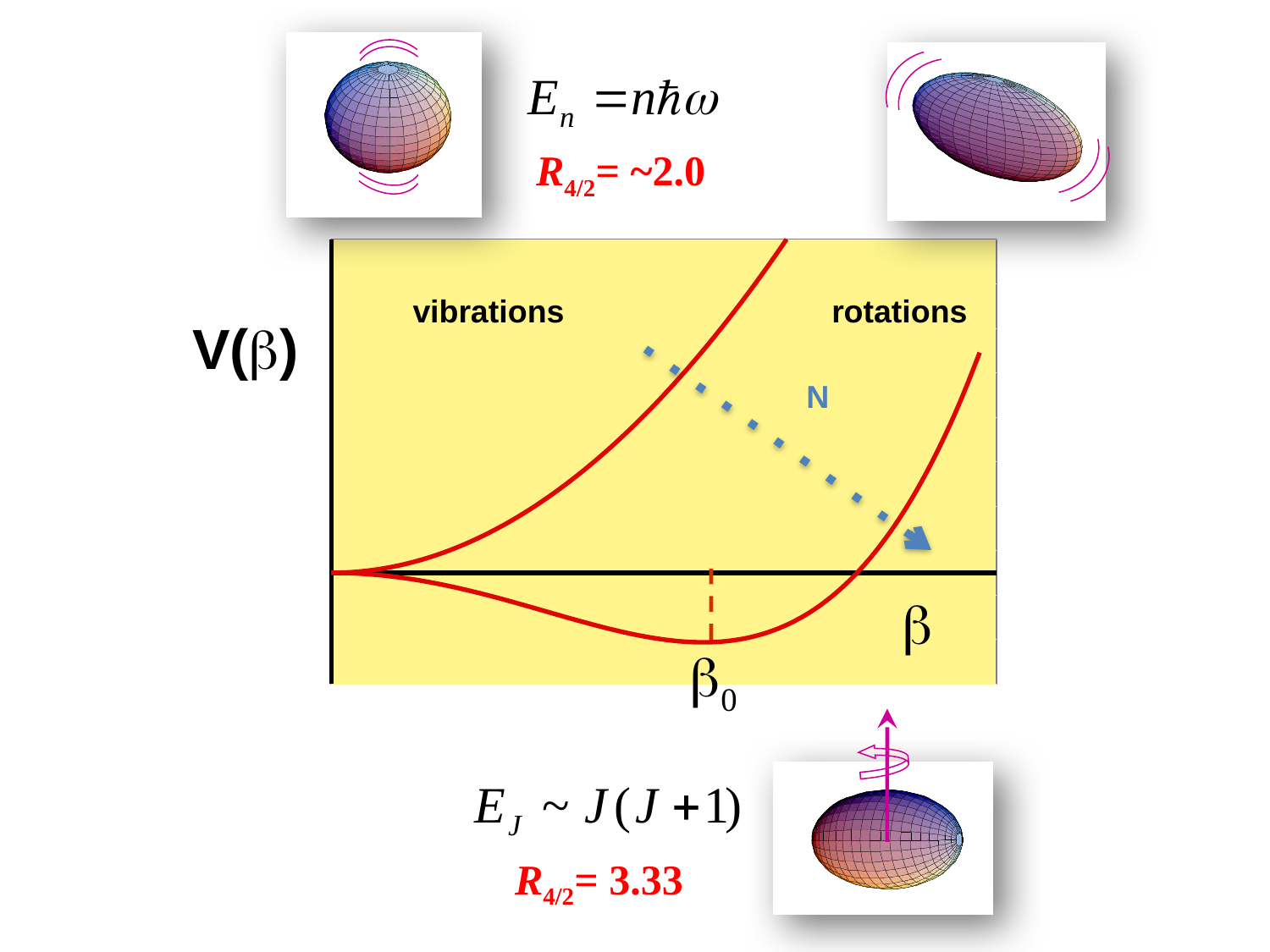
At which marked value of β does the lower curve reach its minimum? β0 Does the lower curve rise or fall as β increases beyond β0? rises What kind of chart is shown on the slide? line chart What is the label on the vertical axis of the chart? V(β) What is the label on the horizontal axis of the chart? β How many red curves are plotted in the chart? 2 Which curve has the lower minimum value, the upper curve or the lower curve? the lower curve Does the upper curve rise or fall as β increases? rises Which of the two curves dips below the horizontal axis, the upper one or the lower one? the lower one